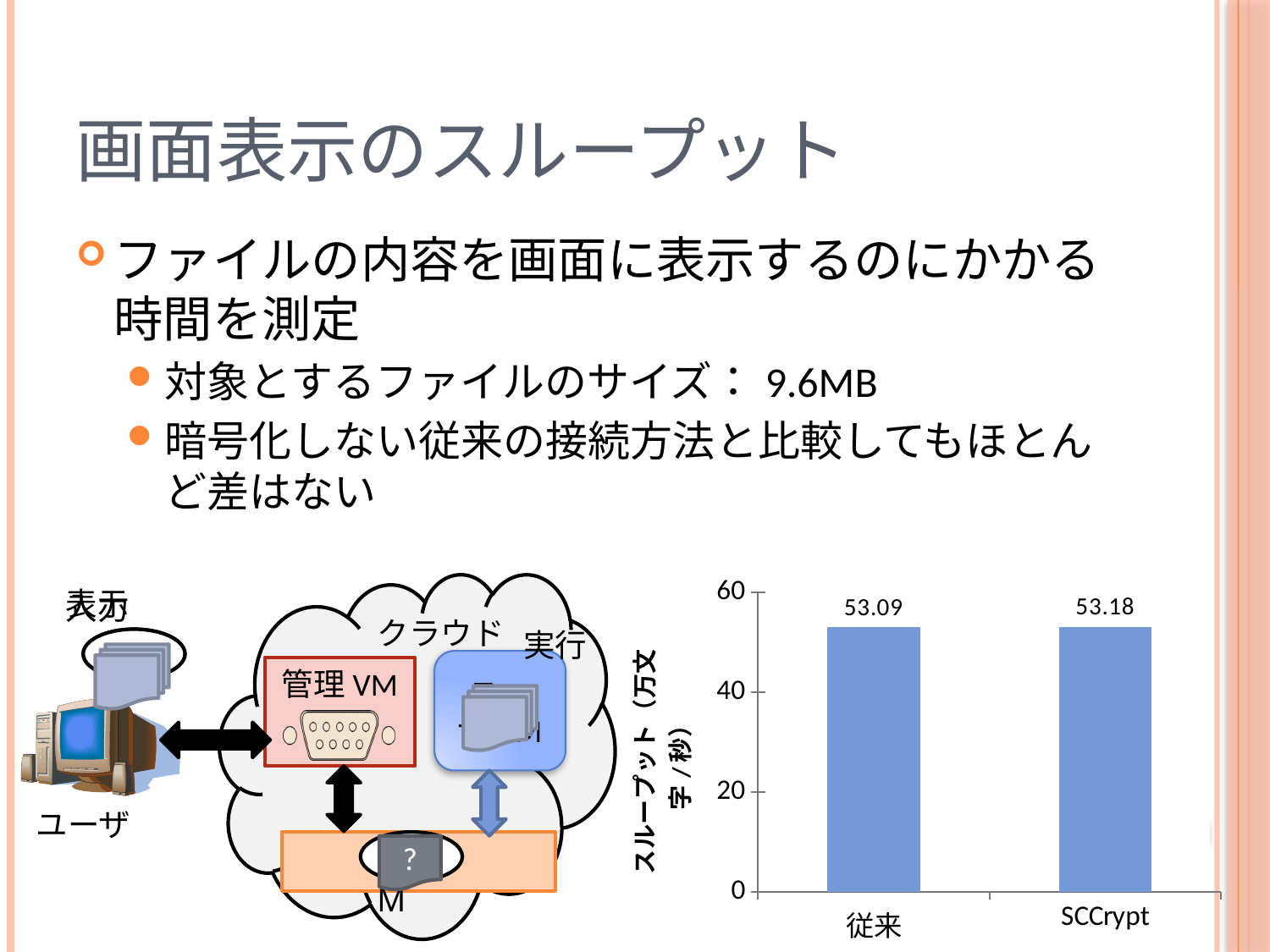
What is the value for 従来 in the chart? 53.09 Is the value for 従来 greater or less than 40? greater What is the value for SCCrypt in the chart? 53.18 How many categories are shown on the x axis of the chart? 2 What is the label of the vertical axis of the chart? スループット（万文字/秒） According to the data labels, which is larger, the value for 従来 or the value for SCCrypt? SCCrypt Is the value for SCCrypt greater or less than 60? less What kind of chart is shown on the slide? bar chart What is the highest tick value shown on the vertical axis of the chart? 60 What is the difference between the values for SCCrypt and 従来? 0.09